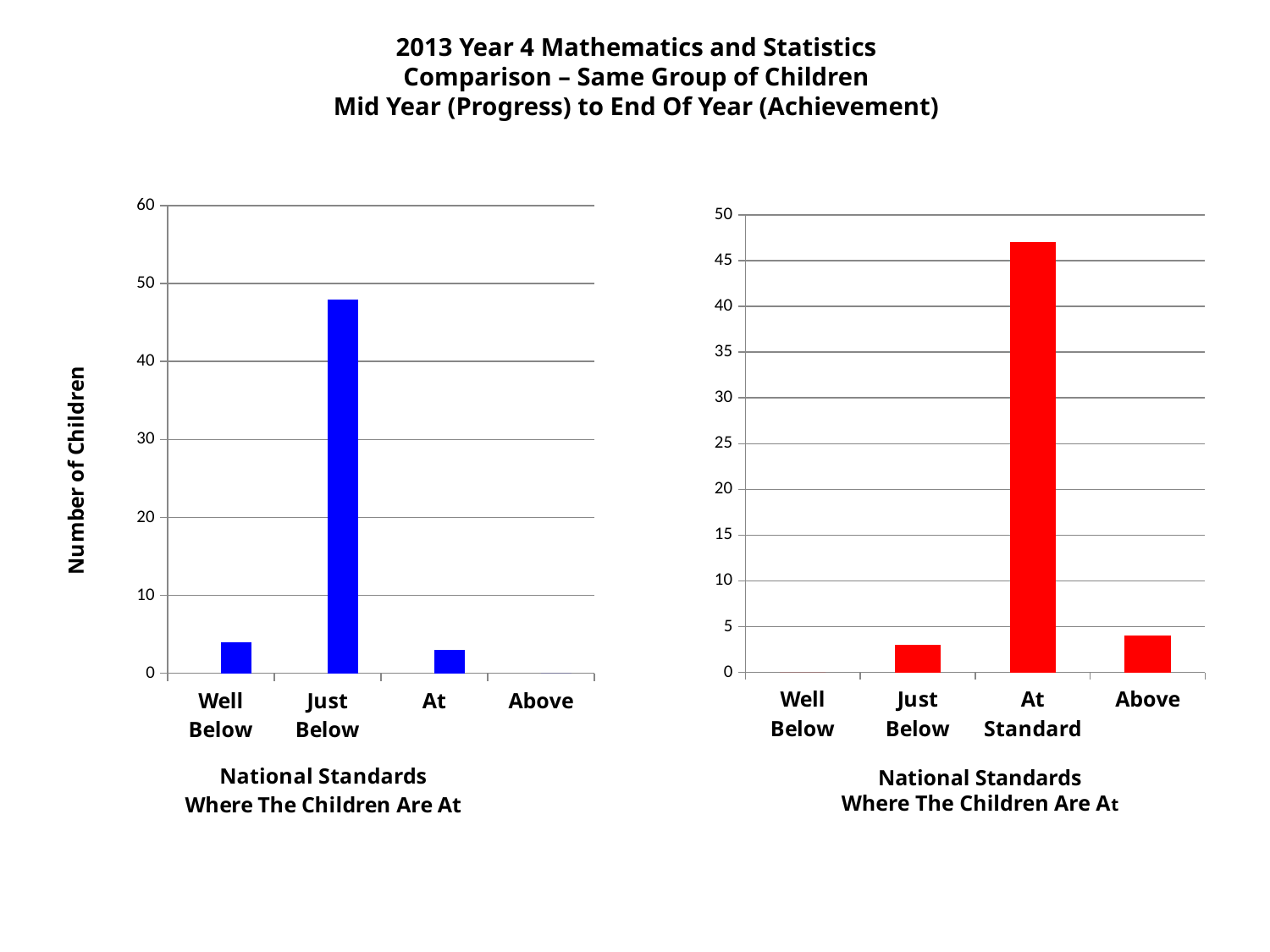
In the right (red) chart, is the value for Just Below greater or less than 5? less What is the label on the vertical axis of the left chart? Number of Children In the right (red) chart, is the value for Above greater or less than 10? less In the right (red) chart, which category has the highest number of children? At Standard In the left (blue) chart, which category has the lowest number of children? Above In the left (blue) chart, which category has the highest number of children? Just Below In the right (red) chart, is the value for At Standard greater or less than 45? greater What kind of chart is the left chart on the slide? bar chart In the right (red) chart, which category has the lowest number of children? Well Below How many categories are shown on the x axis of the left (blue) chart? 4